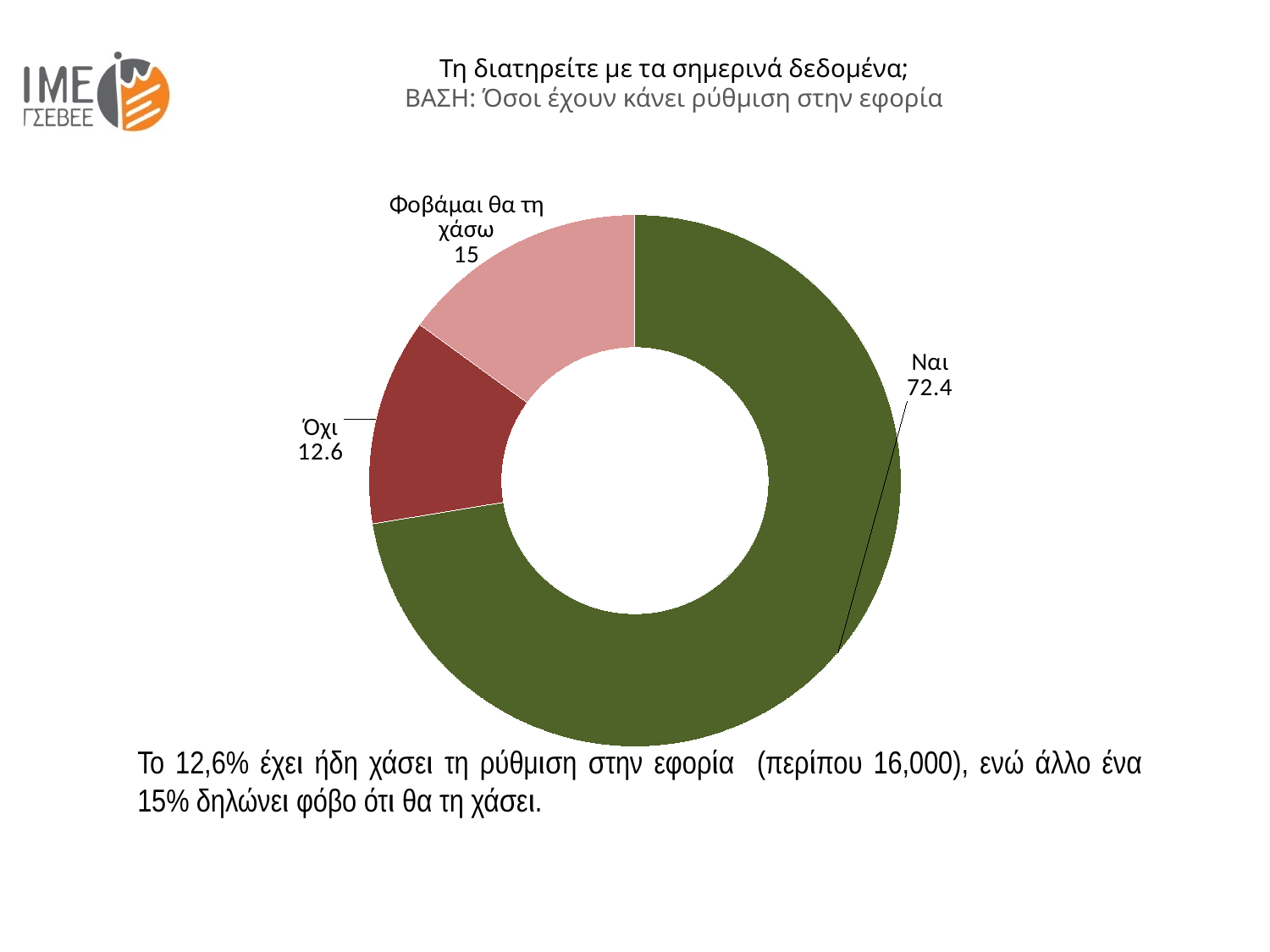
What is the value for the "Όχι" slice? 12.6 What is the difference between the values for "Φοβάμαι θα τη χάσω" and "Όχι"? 2.4 Which is larger, the value for "Όχι" or the value for "Φοβάμαι θα τη χάσω"? Φοβάμαι θα τη χάσω What is the value for the "Φοβάμαι θα τη χάσω" slice? 15 How many categories are shown in the chart? 3 What is the title of the chart? Τη διατηρείτε με τα σημερινά δεδομένα; ΒΑΣΗ: Όσοι έχουν κάνει ρύθμιση στην εφορία What is the difference between the values for "Ναι" and "Όχι"? 59.8 Which category has the largest slice? Ναι What is the value for the "Ναι" slice? 72.4 What colour is the "Ναι" slice? Dark green What type of chart is shown on the slide? Doughnut (pie) chart Which category has the smallest slice? Όχι